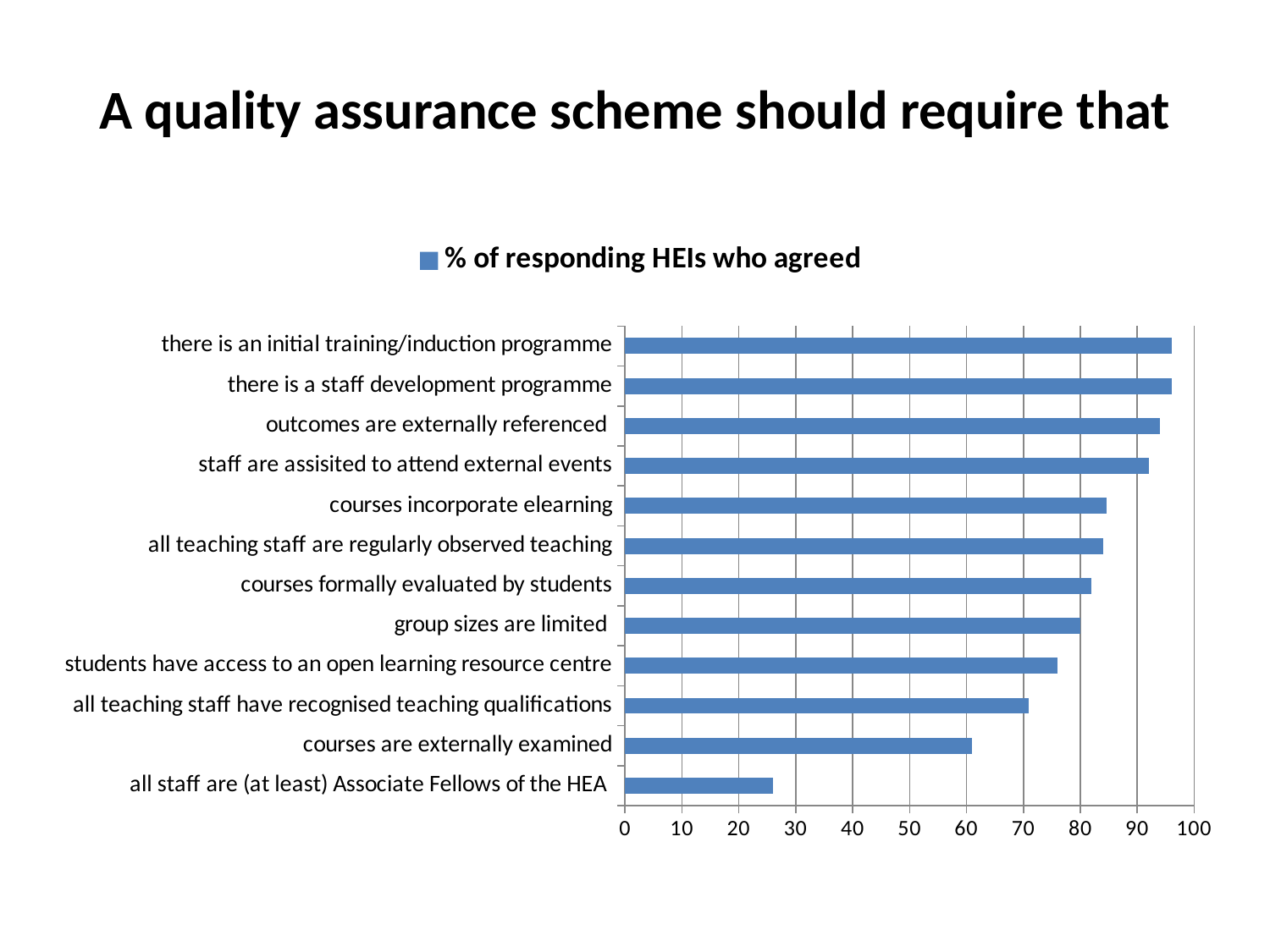
Is the value for 'all staff are (at least) Associate Fellows of the HEA' greater or less than 30? less Which is larger: the value for 'courses are externally examined' or the value for 'group sizes are limited'? group sizes are limited Is the value for 'courses are externally examined' greater or less than 70? less Is the value for 'outcomes are externally referenced' greater or less than 90? greater How many series does the legend list? 1 What kind of chart is shown on the slide? bar chart What is the legend entry for the series in the chart? % of responding HEIs who agreed Which is larger: the value for 'students have access to an open learning resource centre' or the value for 'all staff are (at least) Associate Fellows of the HEA'? students have access to an open learning resource centre How many categories are plotted in the chart? 12 Which category has the lowest value in the chart? all staff are (at least) Associate Fellows of the HEA